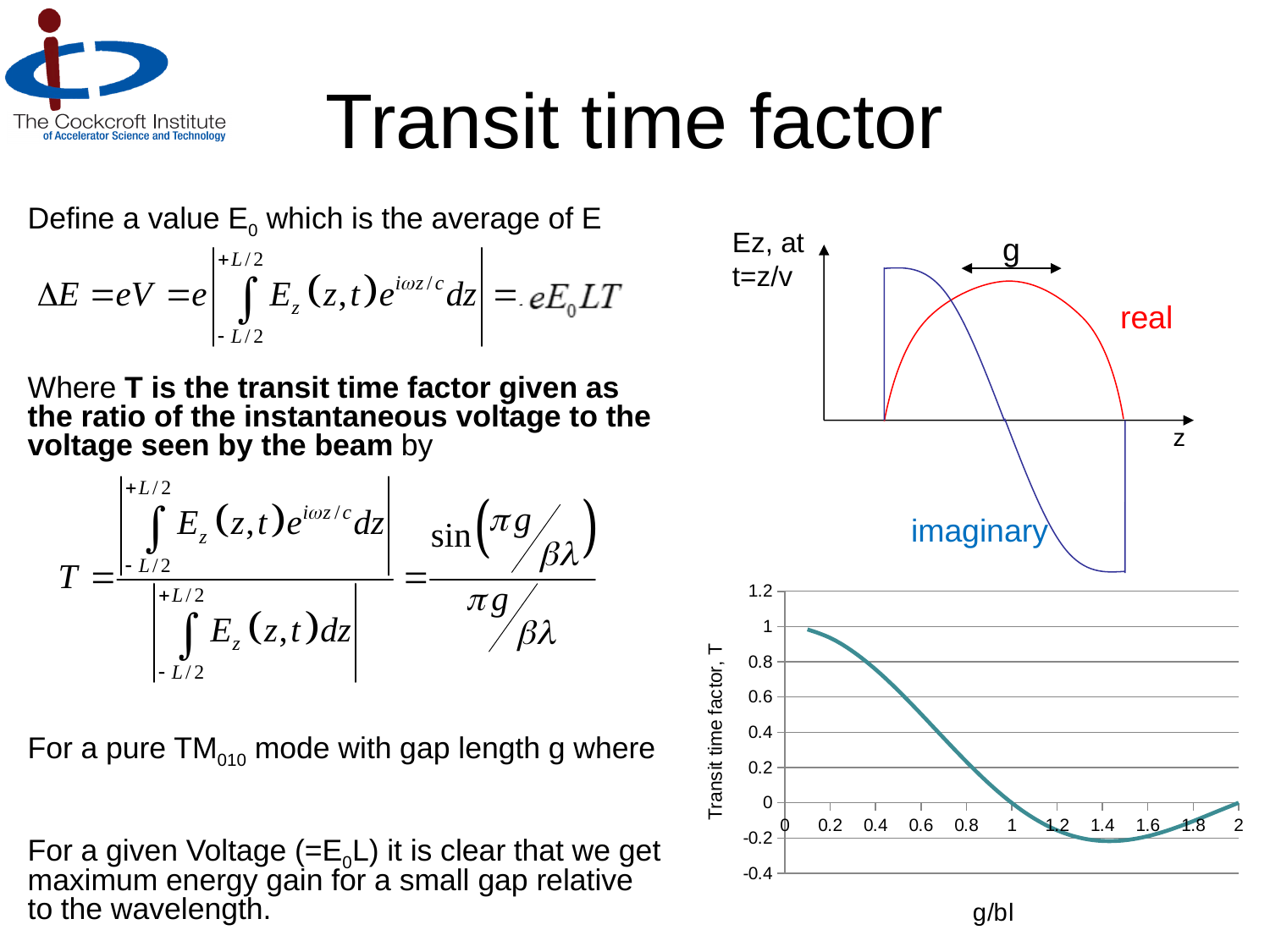
In the bottom-right chart, which is larger: T at g/bl = 0.2 or T at g/bl = 1.2? T at g/bl = 0.2 What is the label on the x axis of the bottom-right chart? g/bl In the bottom-right chart, how does the transit time factor T change as g/bl increases from 0 to 1? it falls In the top-right Ez versus z diagram, what colour is the curve labelled 'real'? red In the bottom-right chart, is the value of T at g/bl = 0.8 greater or less than 0.4? less What kind of chart is shown at the bottom right of the slide (Transit time factor, T versus g/bl)? line chart In the bottom-right chart, is the value of T at g/bl = 0.2 greater or less than 0.8? greater In the bottom-right chart, around which g/bl value does T reach its lowest point? 1.4 In the bottom-right chart, is the value of T at g/bl = 0.6 greater or less than 0.8? less How many lines are plotted in the bottom-right chart? 1